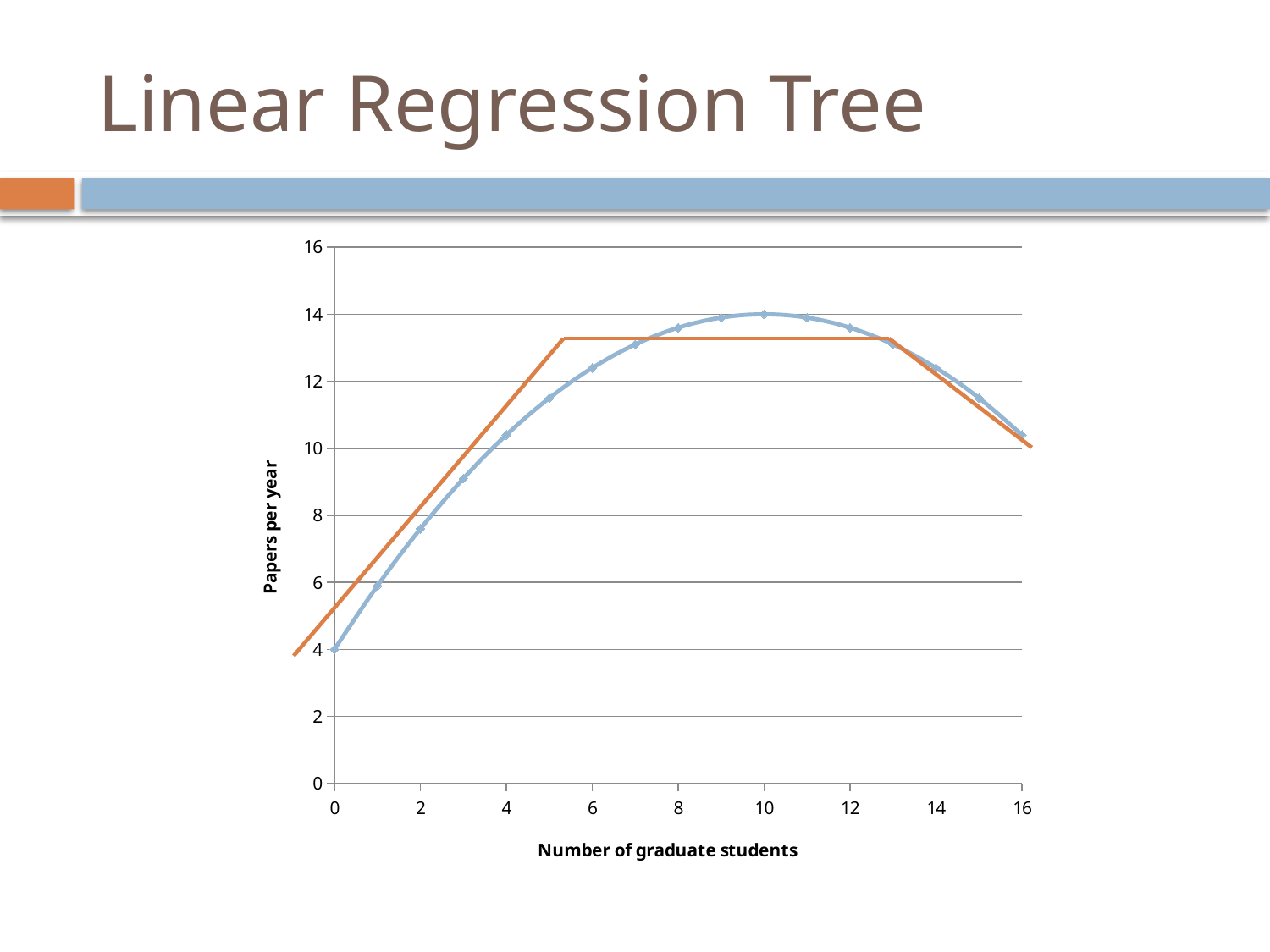
Does the blue curve rise or fall as the number of graduate students increases from 10 to 16? fall What is the value of the blue curve at 0 graduate students? 4 What is the label of the y axis? Papers per year At 10 graduate students, which line has the higher value, the blue curve or the orange line? the blue curve What is the label of the x axis? Number of graduate students Is the value of the blue curve at 2 graduate students greater or less than 8? less Is the value of the blue curve at 8 graduate students greater or less than 12? greater What is the value of the blue curve at 10 graduate students? 14 At 3 graduate students, which line has the higher value, the blue curve or the orange line? the orange line At what number of graduate students does the blue curve reach its highest value? 10 Is the value of the blue curve at 5 graduate students greater or less than 12? less What kind of chart is shown on the slide? line chart